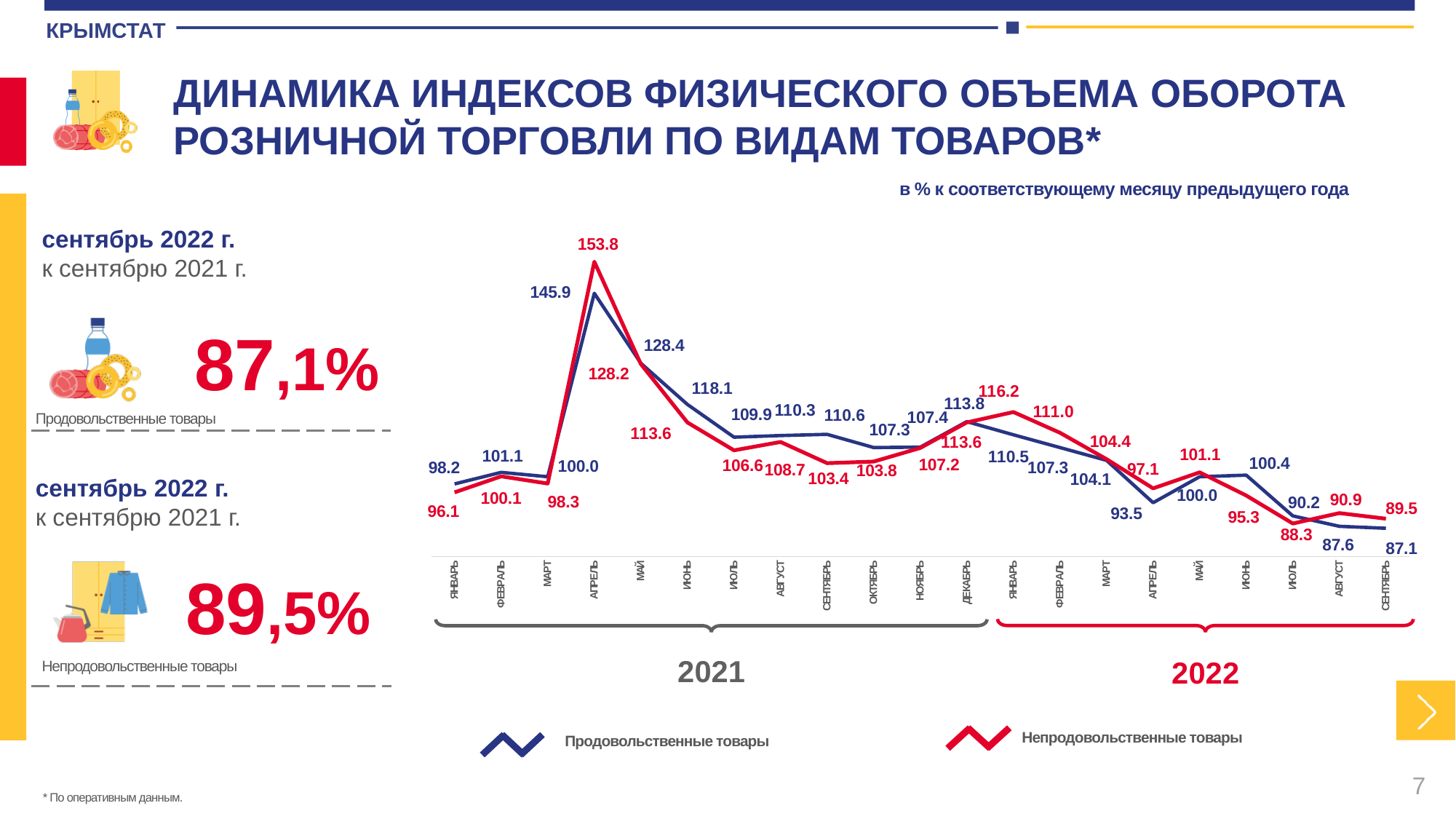
What is the value for Непродовольственные товары in April (Апрель) 2021? 153.8 What is the difference between the Непродовольственные товары and Продовольственные товары values in April (Апрель) 2021? 7.9 What is the value for Продовольственные товары in April (Апрель) 2021? 145.9 What kind of chart is shown on the slide? line chart What is the value for Непродовольственные товары in September (Сентябрь) 2022? 89.5 In which month is the value for Непродовольственные товары the highest? Апрель 2021 How many series does the chart legend list? 2 How many months are plotted on the x axis of the chart? 21 Which series has the larger value in June (Июнь) 2022: Продовольственные товары or Непродовольственные товары? Продовольственные товары In which month is the value for Продовольственные товары the lowest? Сентябрь 2022 What is the value for Продовольственные товары in January (Январь) 2022? 110.5 Does the value for Продовольственные товары rise or fall from May (Май) 2022 to September (Сентябрь) 2022? fall